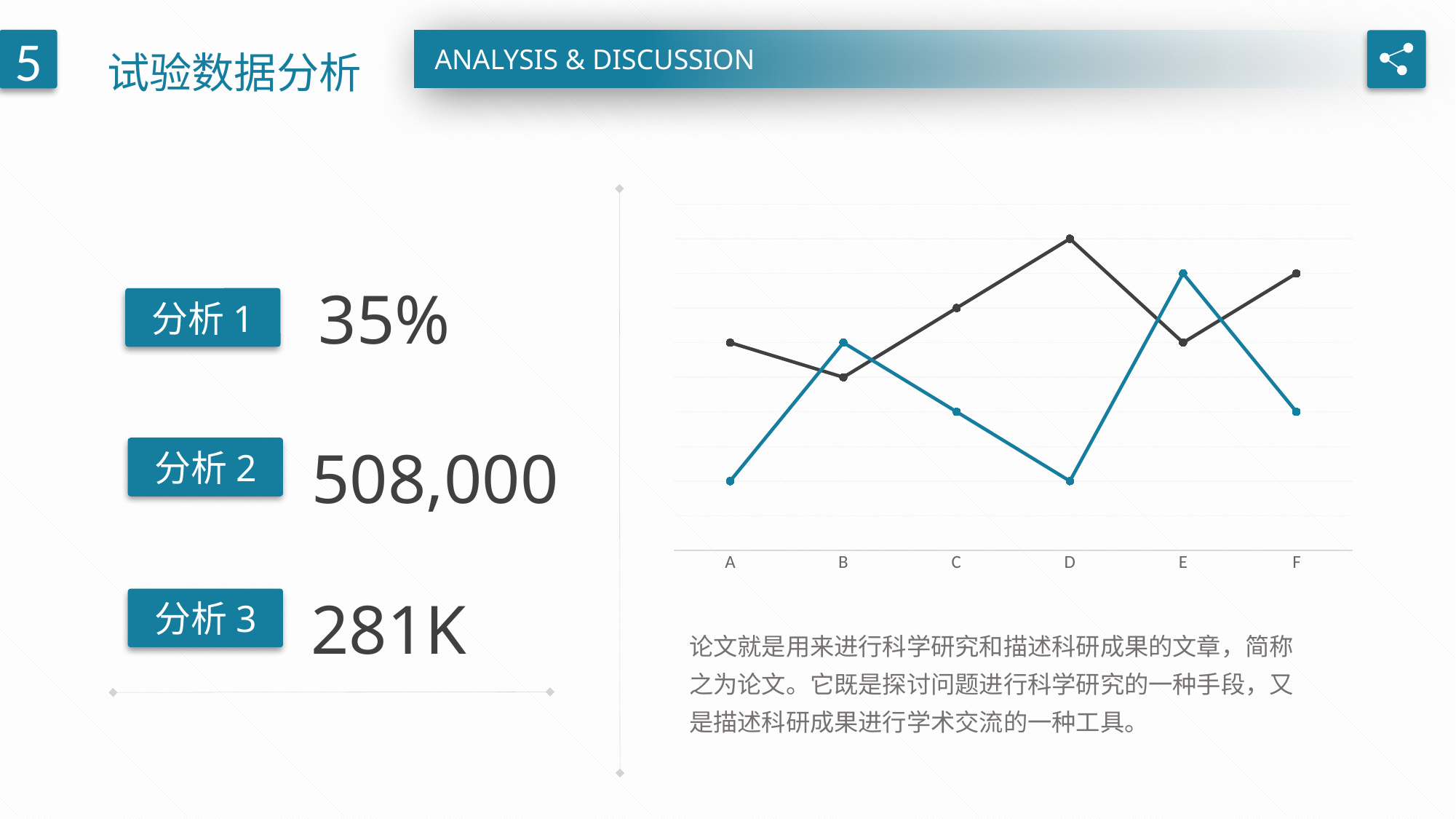
At which category does the dark line reach its lowest point? B What are the labels on the x axis of the chart? A, B, C, D, E, F At which category does the teal line reach its highest point? E Does the dark line rise or fall from category B to category D? rise At category E, which line is higher, the dark line or the teal line? the teal line At which category does the dark line reach its highest point? D Does the teal line rise or fall from category B to category D? fall At category A, which line is higher, the dark line or the teal line? the dark line What kind of chart is shown on the slide? line chart At category B, which line is higher, the dark line or the teal line? the teal line How many lines (series) are plotted in the chart? 2 How many categories are shown on the x axis of the line chart? 6